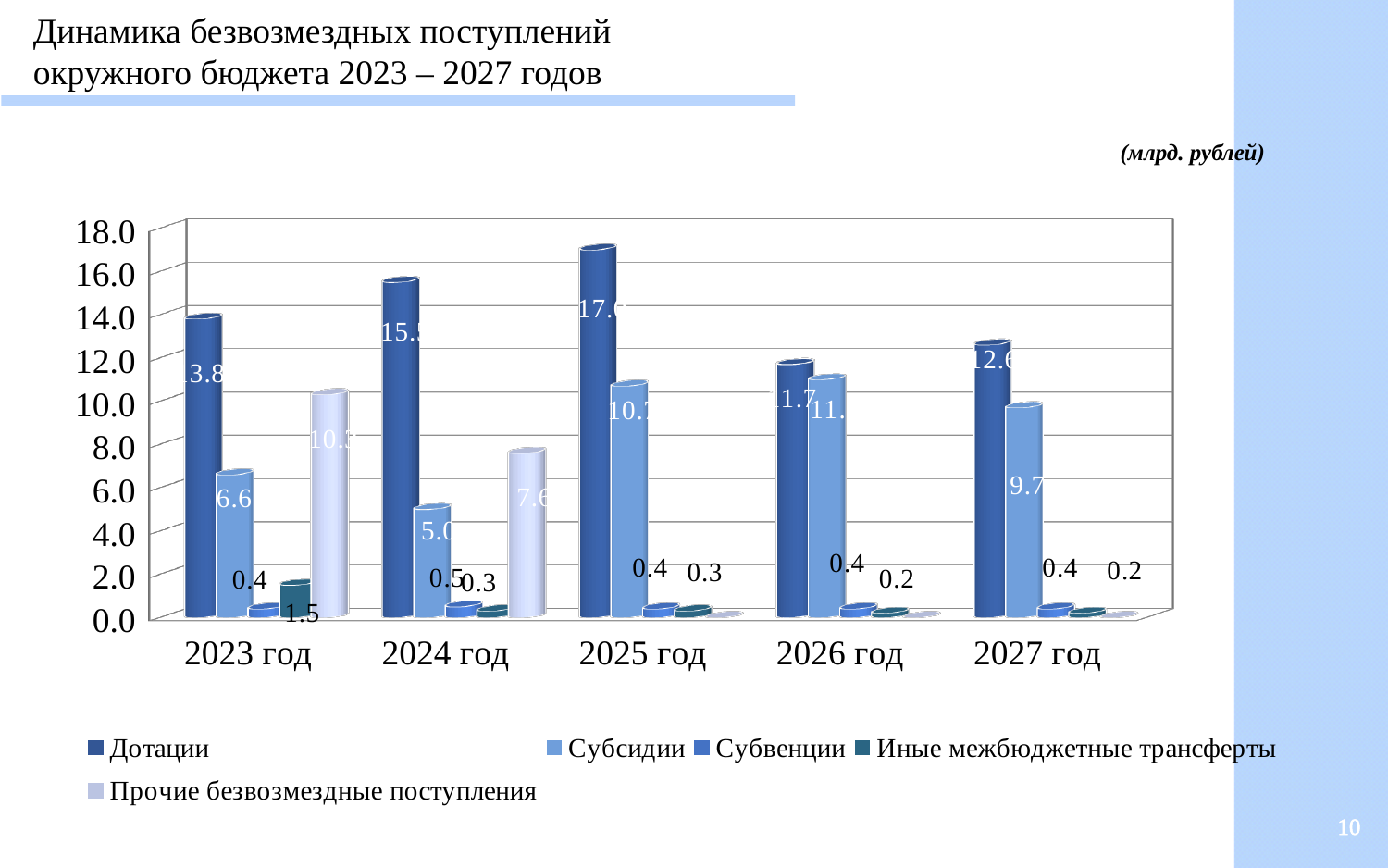
What type of chart is shown on the slide? bar chart How many years (categories) are shown on the x axis of the chart? 5 What is the value for Субсидии in 2023 год? 6.6 In what units are the chart values given, according to the note on the slide? млрд. рублей What is the value for Субвенции in 2024 год? 0.5 How many series does the chart legend list? 5 What is the value for Субсидии in 2027 год? 9.7 Is the value for Дотации in 2025 год greater or less than 16.0? greater What is the difference between the Субсидии values for 2023 год and 2024 год? 1.6 What is the value for Иные межбюджетные трансферты in 2023 год? 1.5 In which year is the value for Дотации the highest? 2025 год Which is larger: the Субсидии value for 2023 год or for 2027 год? 2027 год